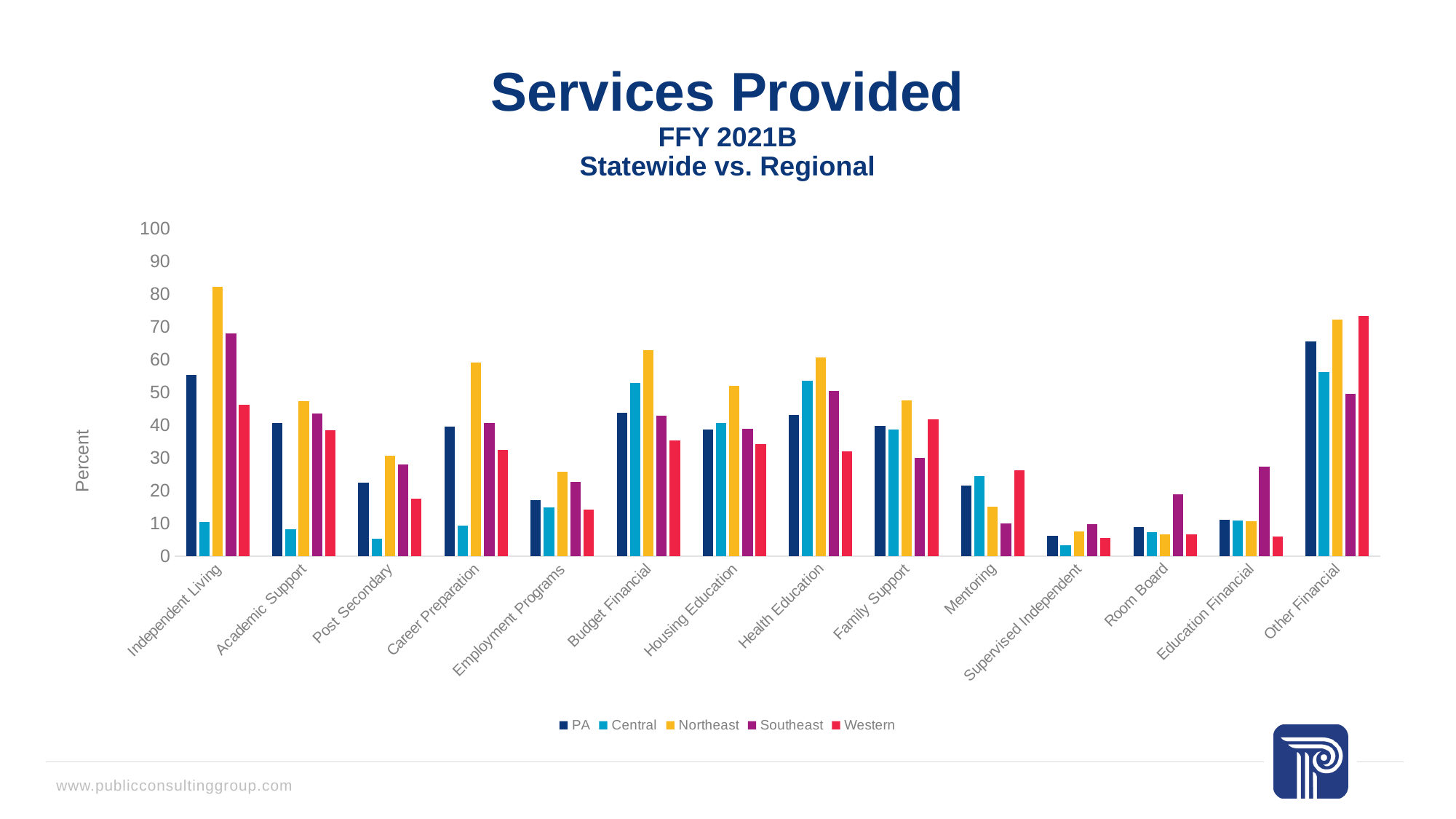
Which series has the lowest value for Post Secondary? Central For Career Preparation, which is larger: the Northeast value or the Southeast value? Northeast Which series has the highest value for Education Financial? Southeast Is the Northeast value for Independent Living greater or less than 70? greater How many service categories are shown on the x axis? 14 How many series does the legend list? 5 What kind of chart is shown on the slide? bar chart Which service category has the highest Northeast value? Independent Living What is the label on the vertical axis? Percent Is the Southeast value for Room Board greater or less than 10? greater For Mentoring, which is larger: the Western value or the Southeast value? Western Is the Central value for Independent Living greater or less than 20? less